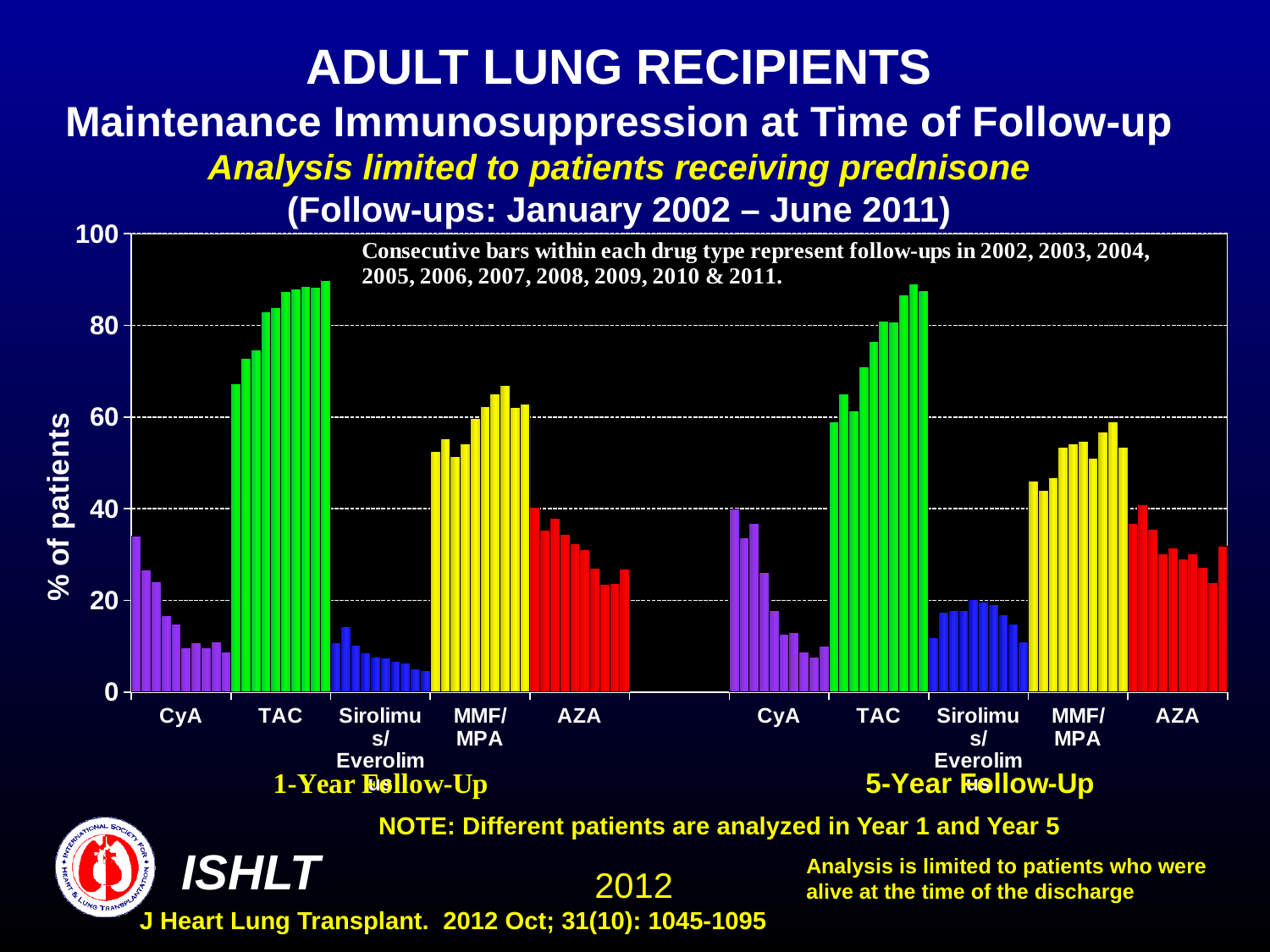
In the 5-Year Follow-Up panel, which drug type has the highest bars? TAC In the 1-Year Follow-Up panel, is the value for the last (2011) TAC bar greater or less than 80? greater In the 1-Year Follow-Up panel, which drug type has the lowest bars? Sirolimus/Everolimus In the 1-Year Follow-Up panel, is the value for the first (2002) CyA bar greater or less than 40? less How many drug types are shown on the x axis of the 1-Year Follow-Up panel? 5 In the 5-Year Follow-Up panel, is the value for the first (2002) Sirolimus/Everolimus bar greater or less than 20? less According to the note on the chart, how many consecutive bars are there within each drug type? 10 What is the label of the y axis? % of patients What kind of chart is shown on the slide? bar chart In the 1-Year Follow-Up panel, do the TAC bars rise or fall from 2002 to 2011? rise In the 1-Year Follow-Up panel, do the CyA bars rise or fall from 2002 to 2011? fall